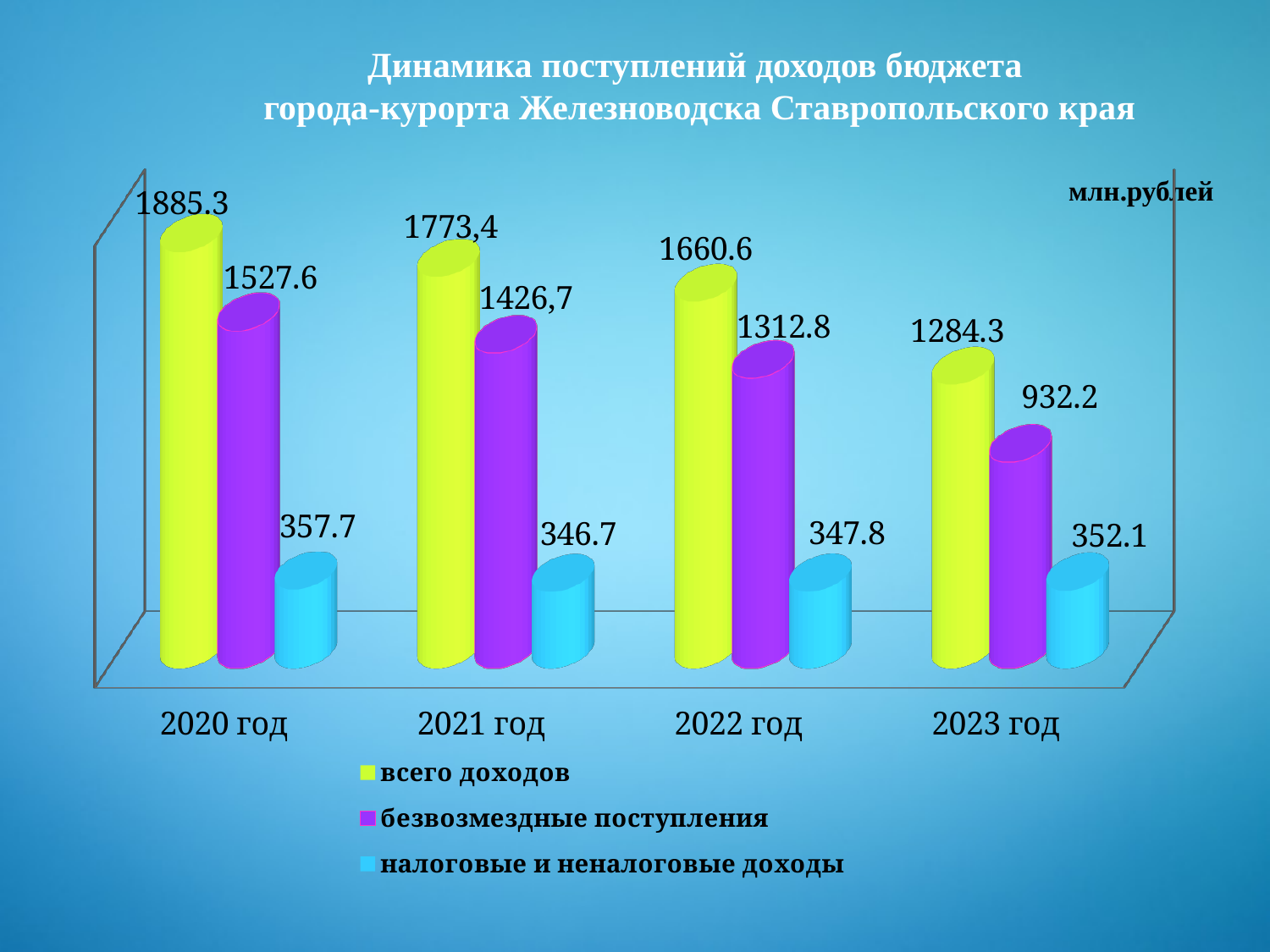
What is the value of всего доходов for 2021 год? 1773,4 How many years are shown on the x axis? 4 In which year is безвозмездные поступления the lowest? 2023 год Which year has the larger value for налоговые и неналоговые доходы, 2020 год or 2023 год? 2020 год Does всего доходов rise or fall from 2020 год to 2023 год? fall What is the difference between безвозмездные поступления in 2022 год and in 2023 год? 380.6 In which year is всего доходов the highest? 2020 год How many series does the legend list? 3 What is the value of налоговые и неналоговые доходы for 2022 год? 347.8 What is the value of безвозмездные поступления for 2023 год? 932.2 What is the value of всего доходов for 2020 год? 1885.3 What is the difference between всего доходов in 2020 год and in 2023 год? 601.0